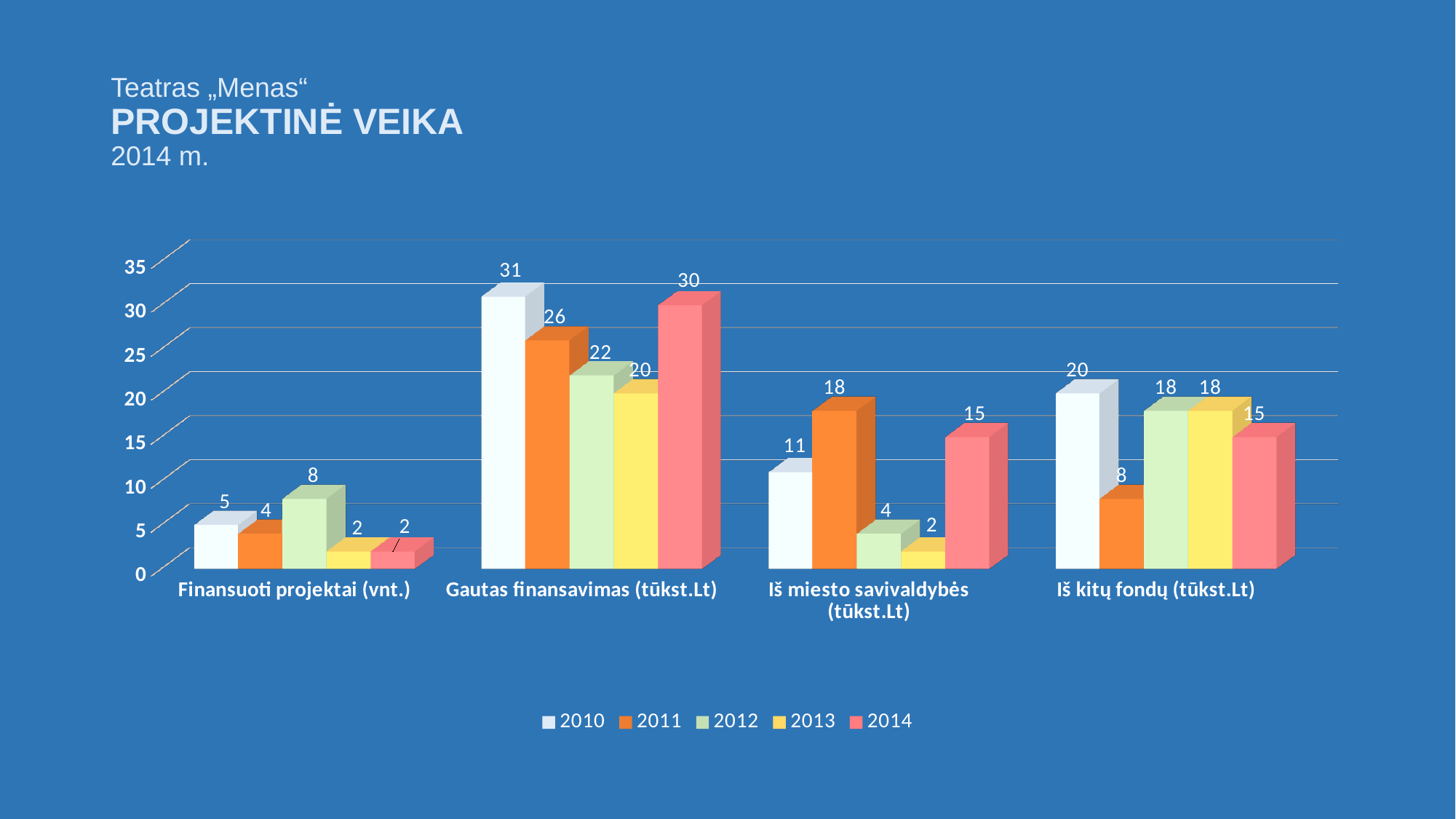
What kind of chart is shown on the slide? Bar chart Which year has the lowest value in the "Iš miesto savivaldybės (tūkst.Lt)" category? 2013 What is the value for 2010 in the "Gautas finansavimas (tūkst.Lt)" category? 31 Which is larger in the "Iš kitų fondų (tūkst.Lt)" category: the 2010 value or the 2014 value? 2010 What is the value for 2011 in the "Iš kitų fondų (tūkst.Lt)" category? 8 What is the value for 2012 in the "Finansuoti projektai (vnt.)" category? 8 What is the difference between the 2014 and 2013 values in the "Gautas finansavimas (tūkst.Lt)" category? 10 What is the value for 2014 in the "Iš miesto savivaldybės (tūkst.Lt)" category? 15 Which year has the highest value in the "Gautas finansavimas (tūkst.Lt)" category? 2010 How many series does the legend list? 5 Which year is shown in orange in the legend? 2011 How many categories are shown on the x axis? 4